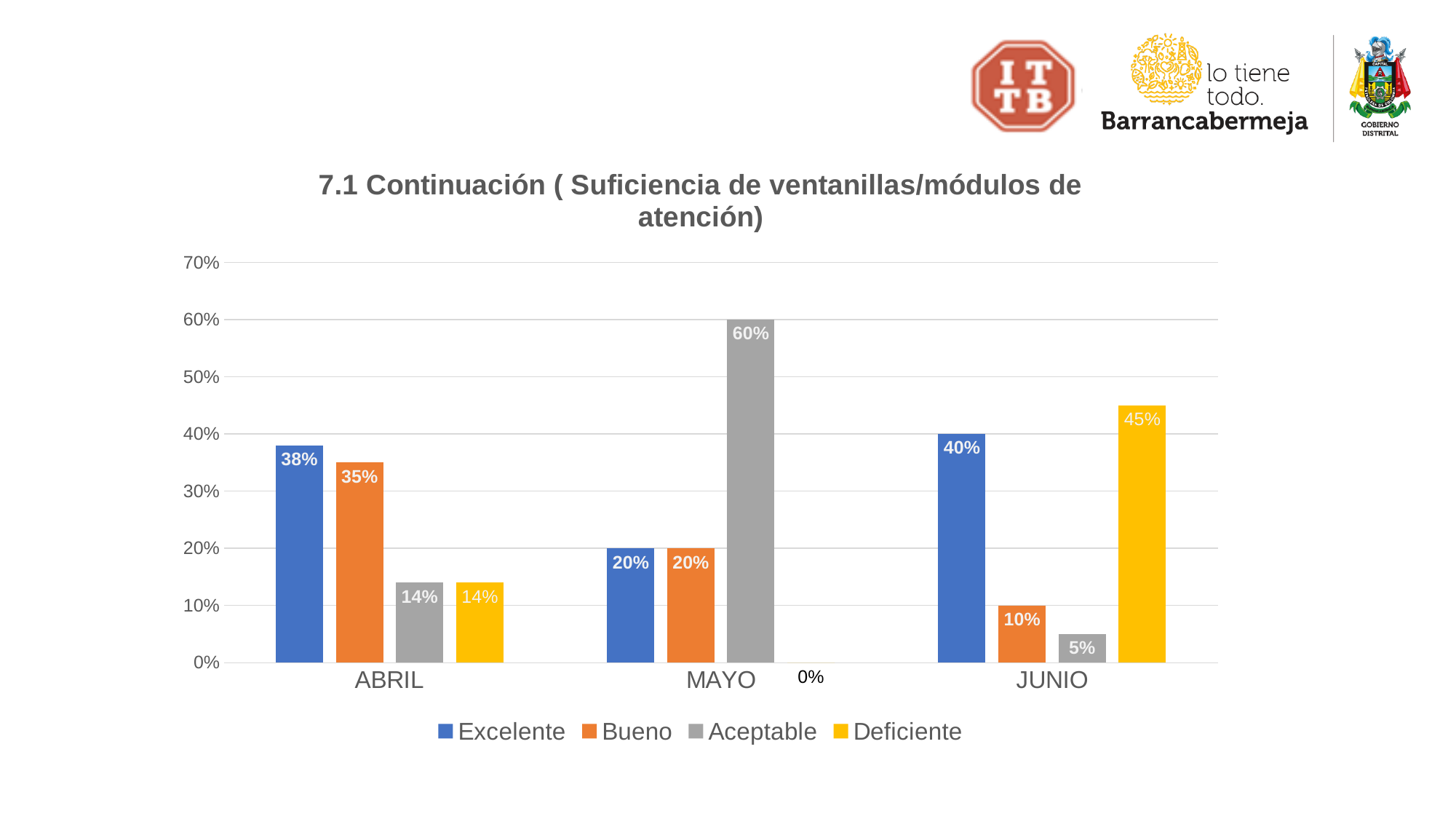
What is the value for Deficiente in MAYO? 0% What is the difference between Deficiente and Bueno in JUNIO? 35% Which is larger in ABRIL, Excelente or Bueno? Excelente How many series does the legend list? 4 What is the value for Excelente in ABRIL? 38% How many months are shown on the x axis? 3 What kind of chart is shown? Bar chart Which series has the highest value in MAYO? Aceptable What is the value for Aceptable in MAYO? 60% Which series has the lowest value in JUNIO? Aceptable Does the value for Deficiente rise or fall from MAYO to JUNIO? Rise What is the value for Deficiente in JUNIO? 45%